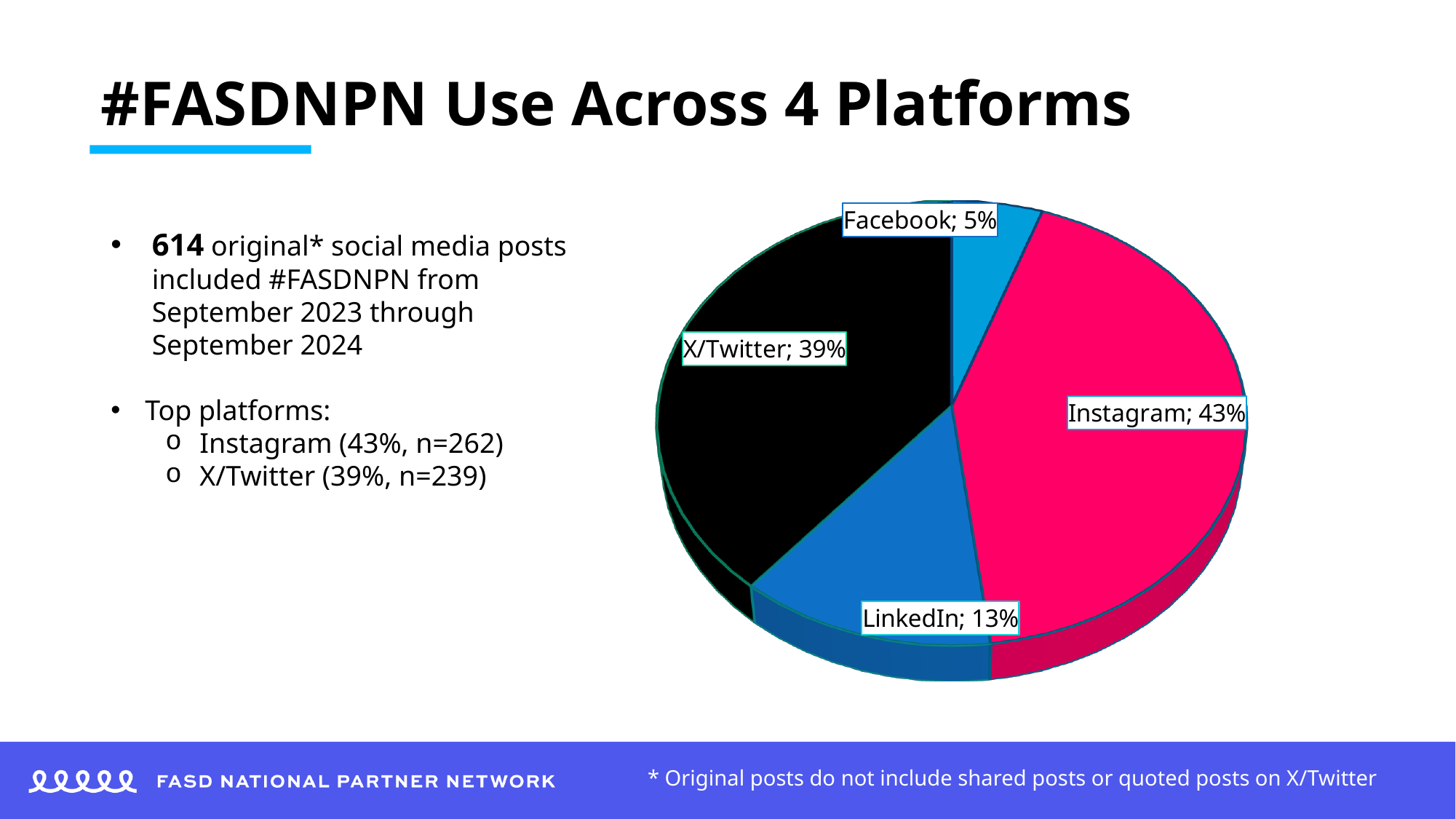
What share of the pie does X/Twitter account for? 39% How many platforms (slices) are shown in the pie chart? 4 Which platform has the smallest slice of the pie? Facebook What share of the pie does Facebook account for? 5% What colour is the X/Twitter slice of the pie? Black Which platform has the largest slice of the pie? Instagram What share of the pie does LinkedIn account for? 13% What is the difference in percentage points between LinkedIn and Facebook? 8 percentage points Which slice is larger, LinkedIn or Facebook? LinkedIn What kind of chart is shown on the slide? Pie chart What is the difference in percentage points between Instagram and X/Twitter? 4 percentage points